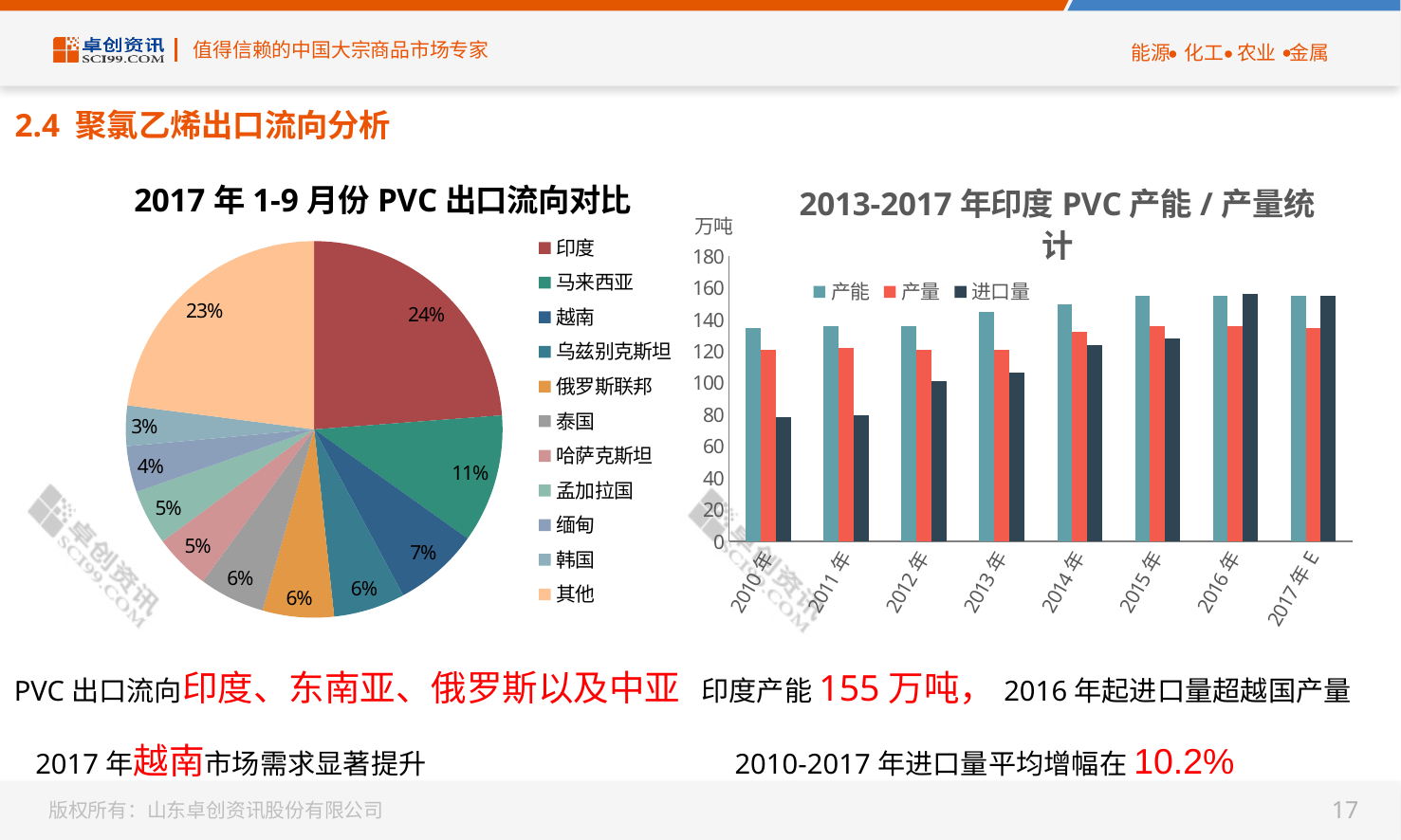
In the pie chart titled 2017年1-9月份PVC出口流向对比, what share does 越南 have? 7% In the bar chart titled 2013-2017年印度PVC产能/产量统计, which is larger for 2010年, 产能 or 进口量? 产能 In the pie chart titled 2017年1-9月份PVC出口流向对比, what share does 印度 have? 24% In the pie chart titled 2017年1-9月份PVC出口流向对比, how many categories does the legend list? 11 In the pie chart titled 2017年1-9月份PVC出口流向对比, which named country (excluding 其他) has the largest share? 印度 What kind of chart is the chart on the right titled 2013-2017年印度PVC产能/产量统计? bar chart In the bar chart titled 2013-2017年印度PVC产能/产量统计, is the value of 进口量 for 2016年 greater or less than 140? greater In the pie chart titled 2017年1-9月份PVC出口流向对比, which category has the smallest share? 韩国 In the pie chart titled 2017年1-9月份PVC出口流向对比, what is the difference between the shares of 印度 and 马来西亚? 13% In the bar chart titled 2013-2017年印度PVC产能/产量统计, does 进口量 generally rise or fall from 2010年 to 2017年E? rise In the bar chart titled 2013-2017年印度PVC产能/产量统计, how many series does the legend list? 3 In the pie chart titled 2017年1-9月份PVC出口流向对比, what share does 马来西亚 have? 11%